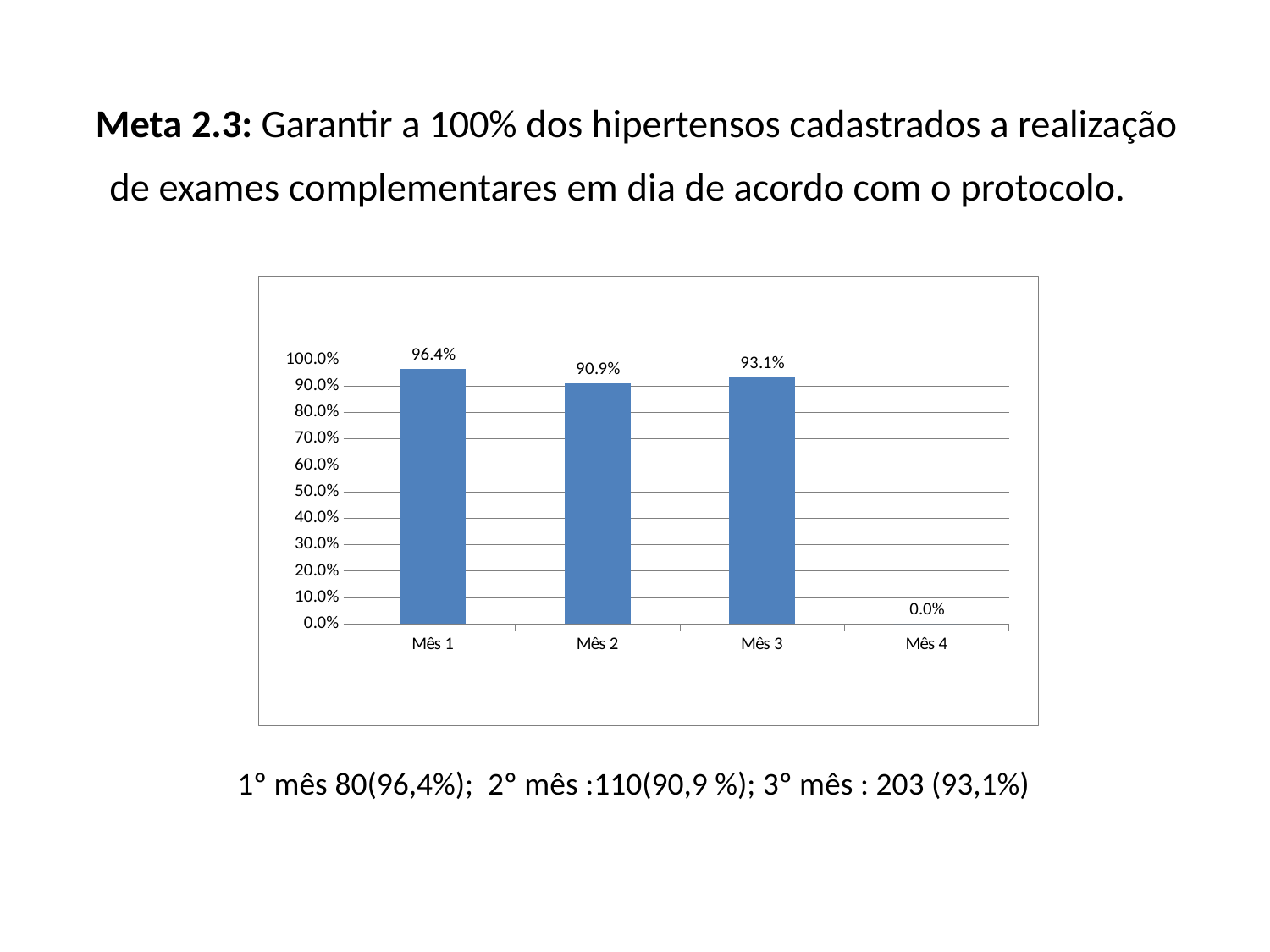
What kind of chart is shown on the slide? bar chart What is the difference between the values for Mês 1 and Mês 2? 5.5% Is the value for Mês 2 greater or less than 90.0%? greater Which is larger, the value for Mês 2 or the value for Mês 3? Mês 3 What is the difference between the values for Mês 3 and Mês 2? 2.2% What is the value for Mês 4? 0.0% Which month has the highest value? Mês 1 How many categories are shown on the x axis? 4 What is the value for Mês 3? 93.1% Which month has the lowest value? Mês 4 What is the value for Mês 2? 90.9% What is the value for Mês 1? 96.4%